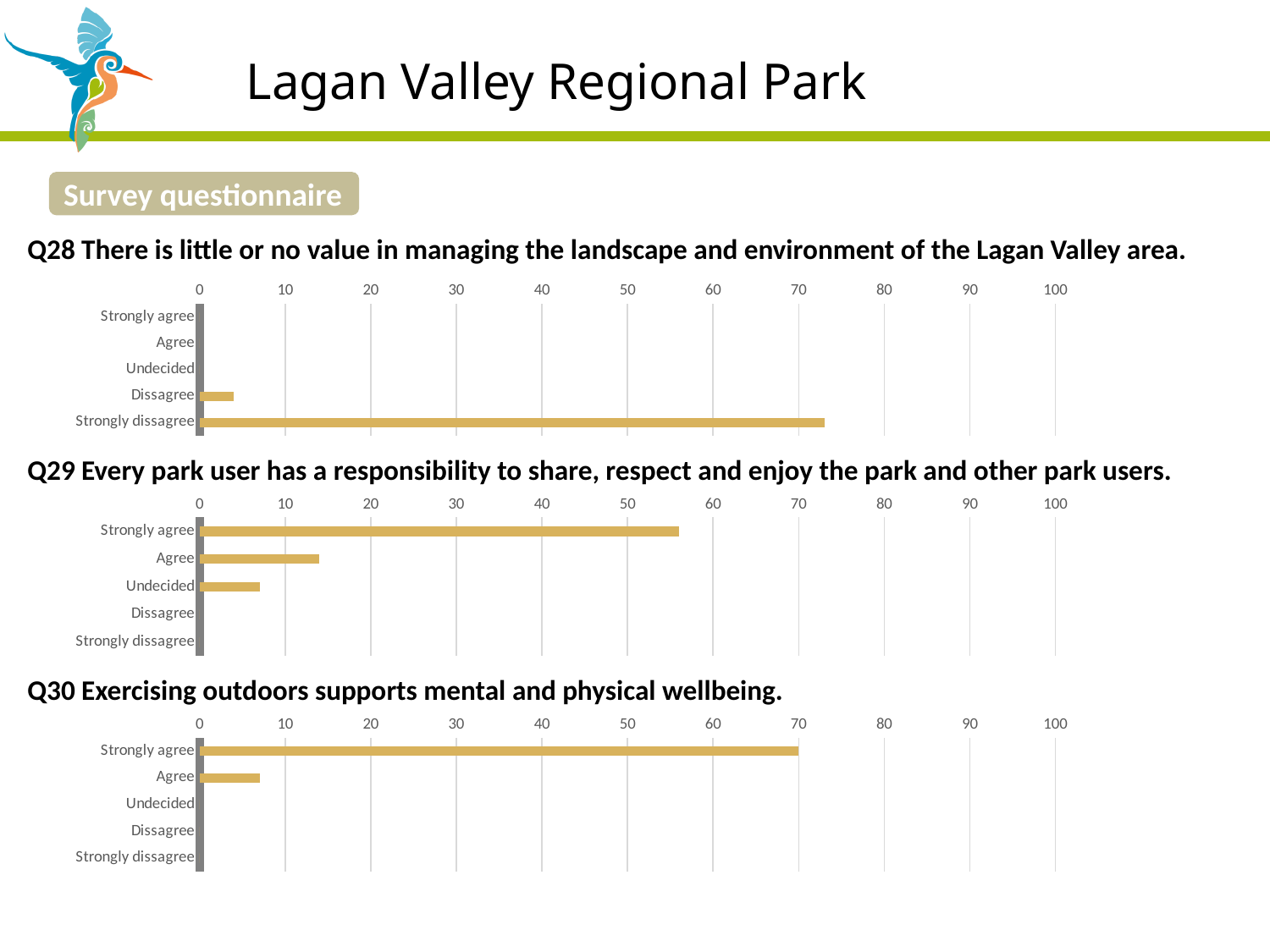
In the Q30 chart, is the value for Strongly agree greater or less than 60? greater In the Q30 chart, which category has the highest value? Strongly agree What is the highest value shown on the x axis of the Q30 chart? 100 What kind of chart is used for Q28? bar chart In the Q28 chart, is the value for Strongly dissagree greater or less than 70? greater In the Q28 chart, is the value for Dissagree greater or less than 10? less In the Q29 chart, which category has the highest value? Strongly agree In the Q29 chart, which is larger, Agree or Undecided? Agree In the Q28 chart, which category has the highest value? Strongly dissagree How many categories are shown on the Q29 chart? 5